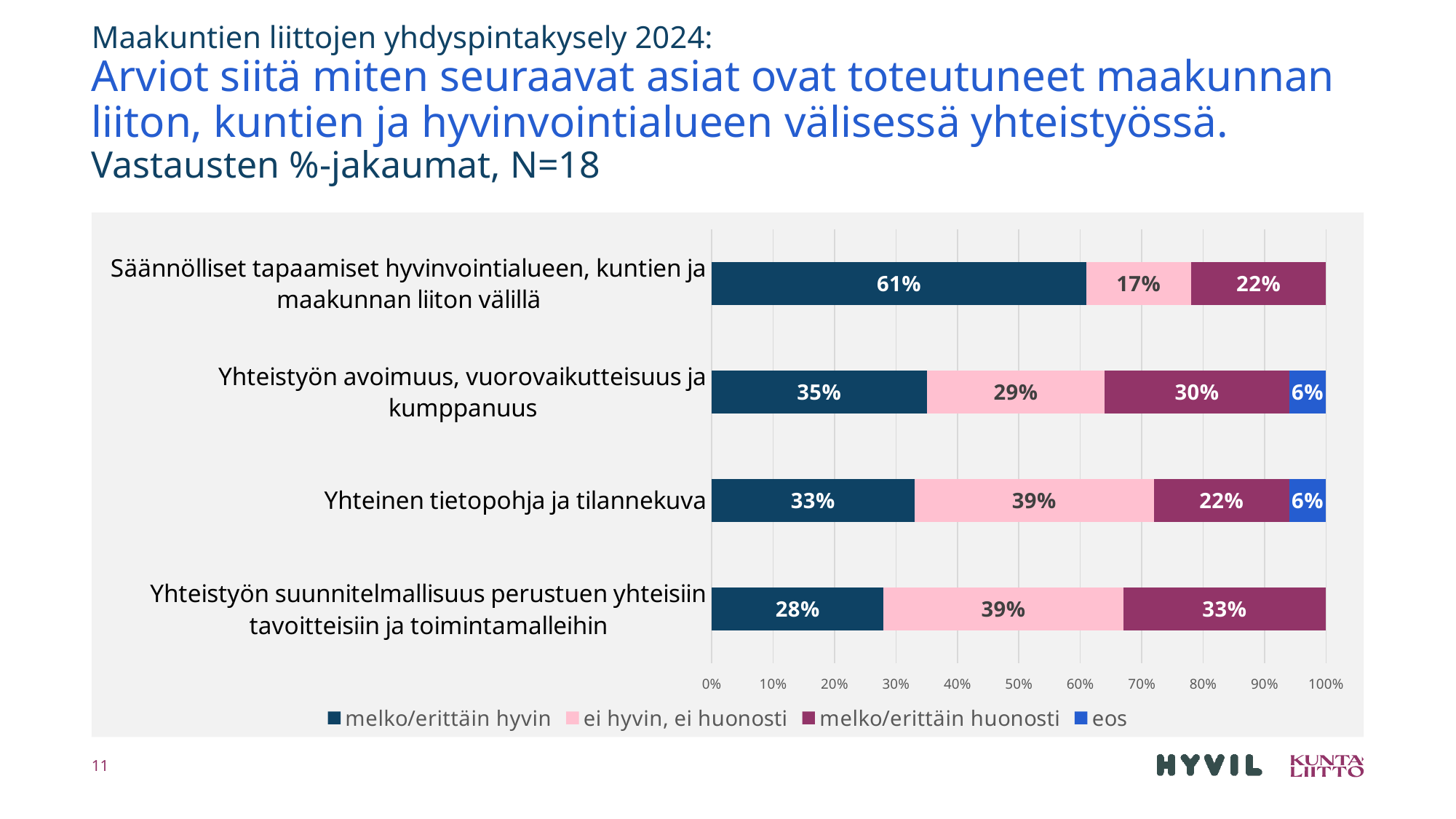
How many categories are shown in the chart? 4 What is the "melko/erittäin huonosti" share for "Yhteistyön avoimuus, vuorovaikutteisuus ja kumppanuus"? 30% What is the difference between the "melko/erittäin hyvin" shares of "Säännölliset tapaamiset hyvinvointialueen, kuntien ja maakunnan liiton välillä" and "Yhteistyön suunnitelmallisuus perustuen yhteisiin tavoitteisiin ja toimintamalleihin"? 33 percentage points What is the "ei hyvin, ei huonosti" share for "Yhteinen tietopohja ja tilannekuva"? 39% Which is larger: the "melko/erittäin huonosti" share for "Yhteistyön suunnitelmallisuus perustuen yhteisiin tavoitteisiin ja toimintamalleihin" or for "Yhteinen tietopohja ja tilannekuva"? Yhteistyön suunnitelmallisuus perustuen yhteisiin tavoitteisiin ja toimintamalleihin What kind of chart is shown on the slide? Stacked bar chart Which category has the highest "melko/erittäin hyvin" share? Säännölliset tapaamiset hyvinvointialueen, kuntien ja maakunnan liiton välillä What percentage of respondents answered "melko/erittäin hyvin" for "Säännölliset tapaamiset hyvinvointialueen, kuntien ja maakunnan liiton välillä"? 61% What is the "eos" share for "Yhteinen tietopohja ja tilannekuva"? 6% What is the N (number of respondents) stated in the slide subtitle? N=18 Which category has the lowest "melko/erittäin hyvin" share? Yhteistyön suunnitelmallisuus perustuen yhteisiin tavoitteisiin ja toimintamalleihin How many series does the legend list? 4